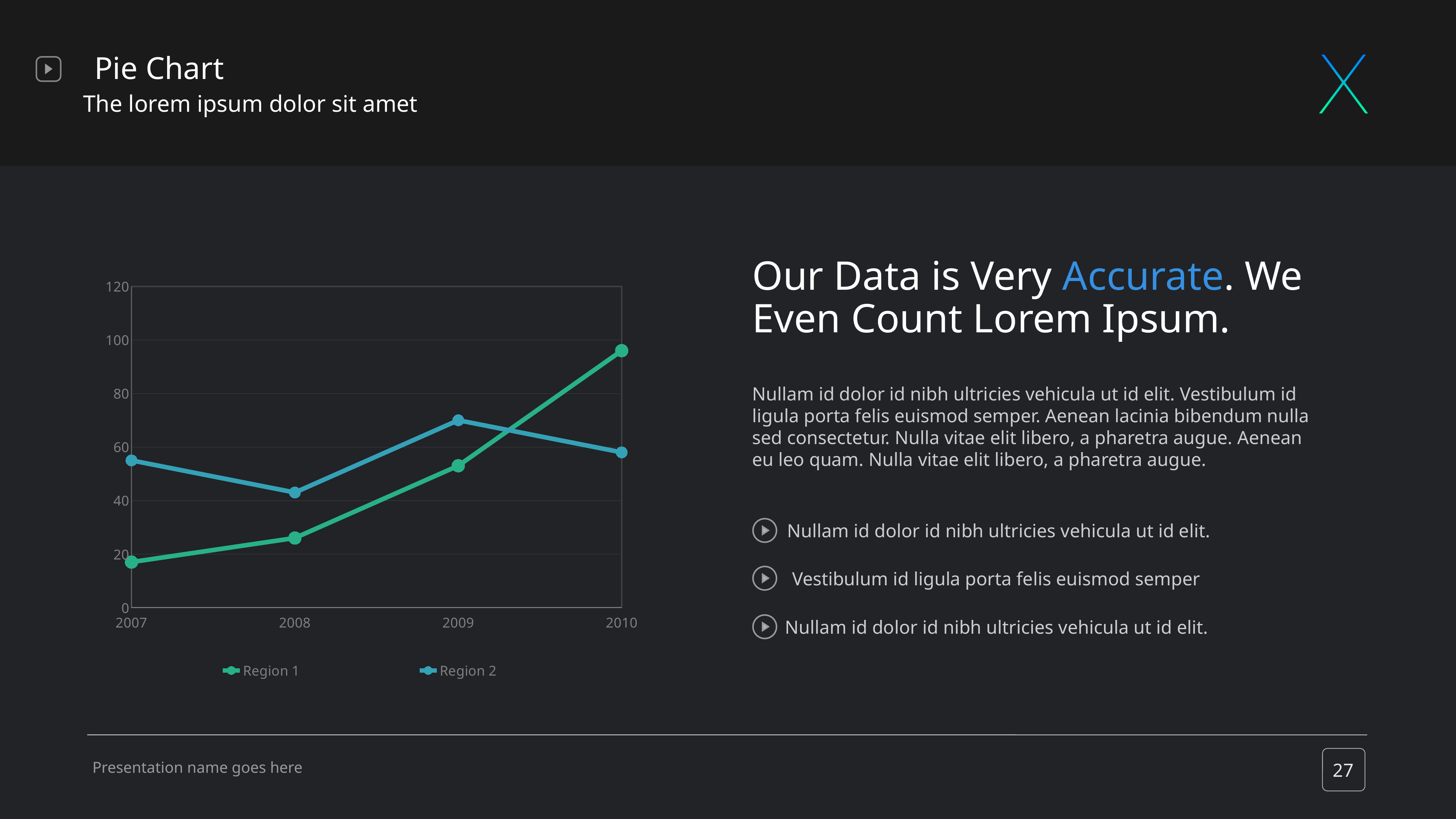
In 2007, which series has the larger value, Region 1 or Region 2? Region 2 How many series does the legend list? 2 How many years are shown on the x axis? 4 In which year is Region 1 highest? 2010 In which year is Region 2 lowest? 2008 Which series are listed in the legend? Region 1 and Region 2 In which year is Region 2 highest? 2009 Is the value for Region 1 in 2010 greater or less than 80? greater What kind of chart is shown on the slide? line chart In which year is Region 1 lowest? 2007 In 2010, which series has the larger value, Region 1 or Region 2? Region 1 Does the value for Region 1 rise or fall from 2007 to 2010? rise